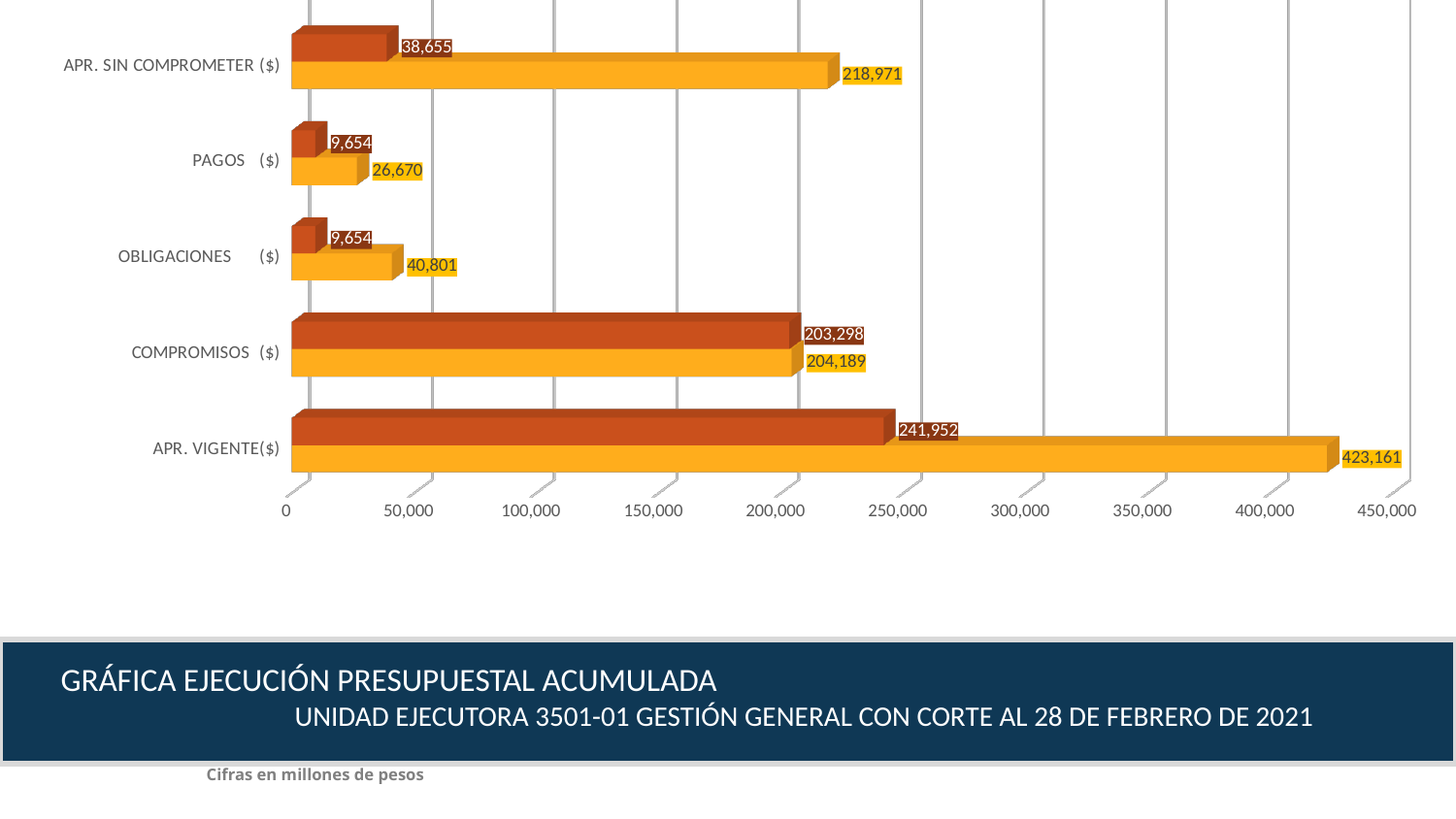
What is the value of the yellow bar for APR. SIN COMPROMETER ($)? 218,971 Which category has the lowest yellow bar value? PAGOS ($) What is the value of the yellow bar for APR. VIGENTE($)? 423,161 How many categories are shown on the vertical axis of the chart? 5 Which category has the highest yellow bar value? APR. VIGENTE($) Which is larger for APR. SIN COMPROMETER ($): the yellow bar or the dark orange bar? the yellow bar What is the difference between the yellow bar and the dark orange bar for APR. VIGENTE($)? 181,209 What is the value of the dark orange bar for APR. VIGENTE($)? 241,952 What is the difference between the yellow bar values for OBLIGACIONES ($) and PAGOS ($)? 14,131 What is the value of the dark orange bar for COMPROMISOS ($)? 203,298 What type of chart is shown on the slide? bar chart What is the value of the yellow bar for OBLIGACIONES ($)? 40,801